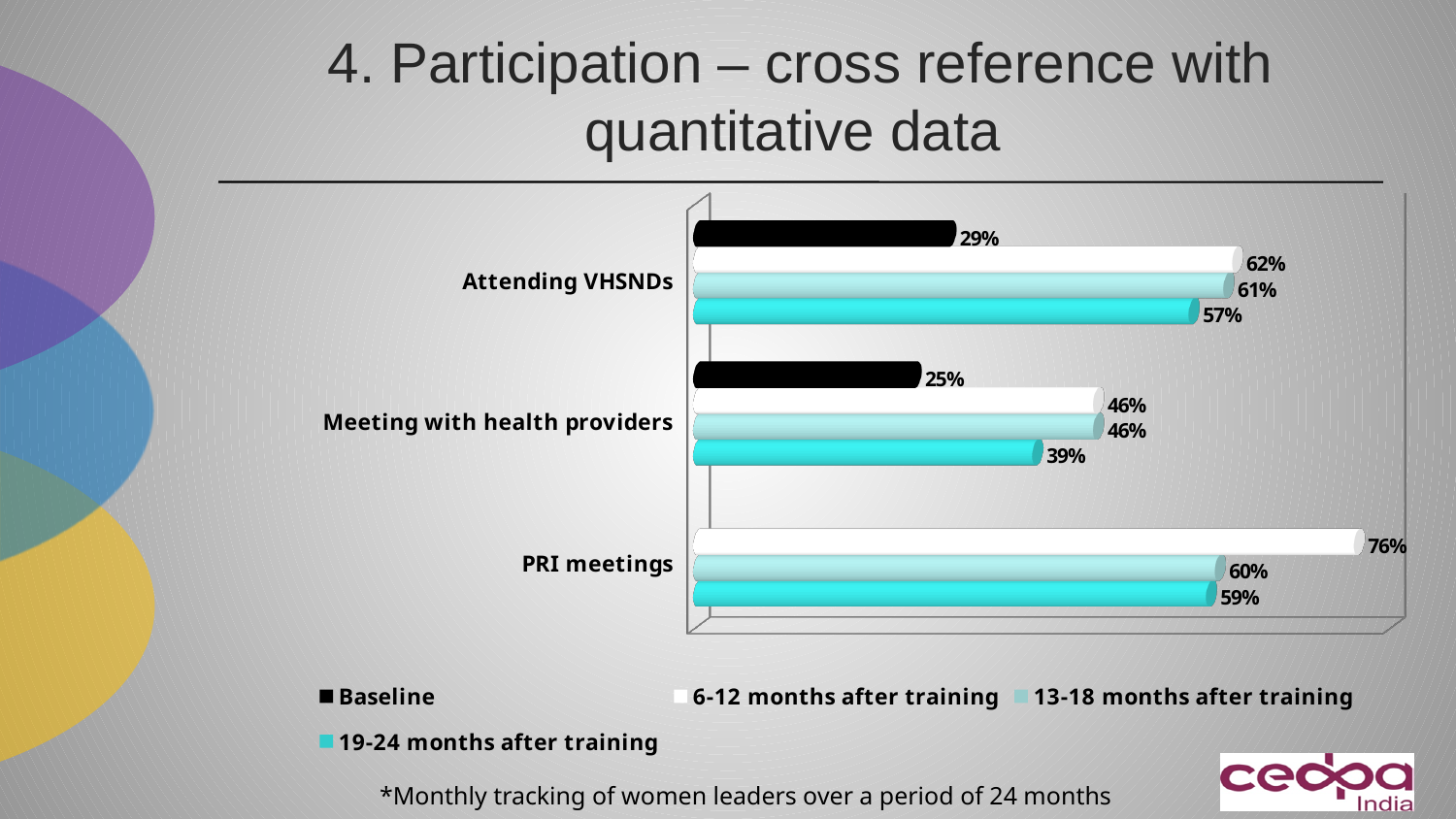
What is the value for PRI meetings 6-12 months after training? 76% Which category has the highest value 6-12 months after training? PRI meetings What is the Baseline value for Attending VHSNDs? 29% How many series does the legend list? 4 Which is larger: the Baseline value for Attending VHSNDs or the Baseline value for Meeting with health providers? Attending VHSNDs What is the difference between the 6-12 months and 13-18 months after training values for PRI meetings? 16% Which category has the lowest value 19-24 months after training? Meeting with health providers What kind of chart is shown on the slide? Bar chart What is the value for Meeting with health providers 19-24 months after training? 39% How many categories are shown on the chart? 3 What is the difference between the 6-12 months after training value and the Baseline value for Attending VHSNDs? 33% What is the value for Attending VHSNDs 13-18 months after training? 61%